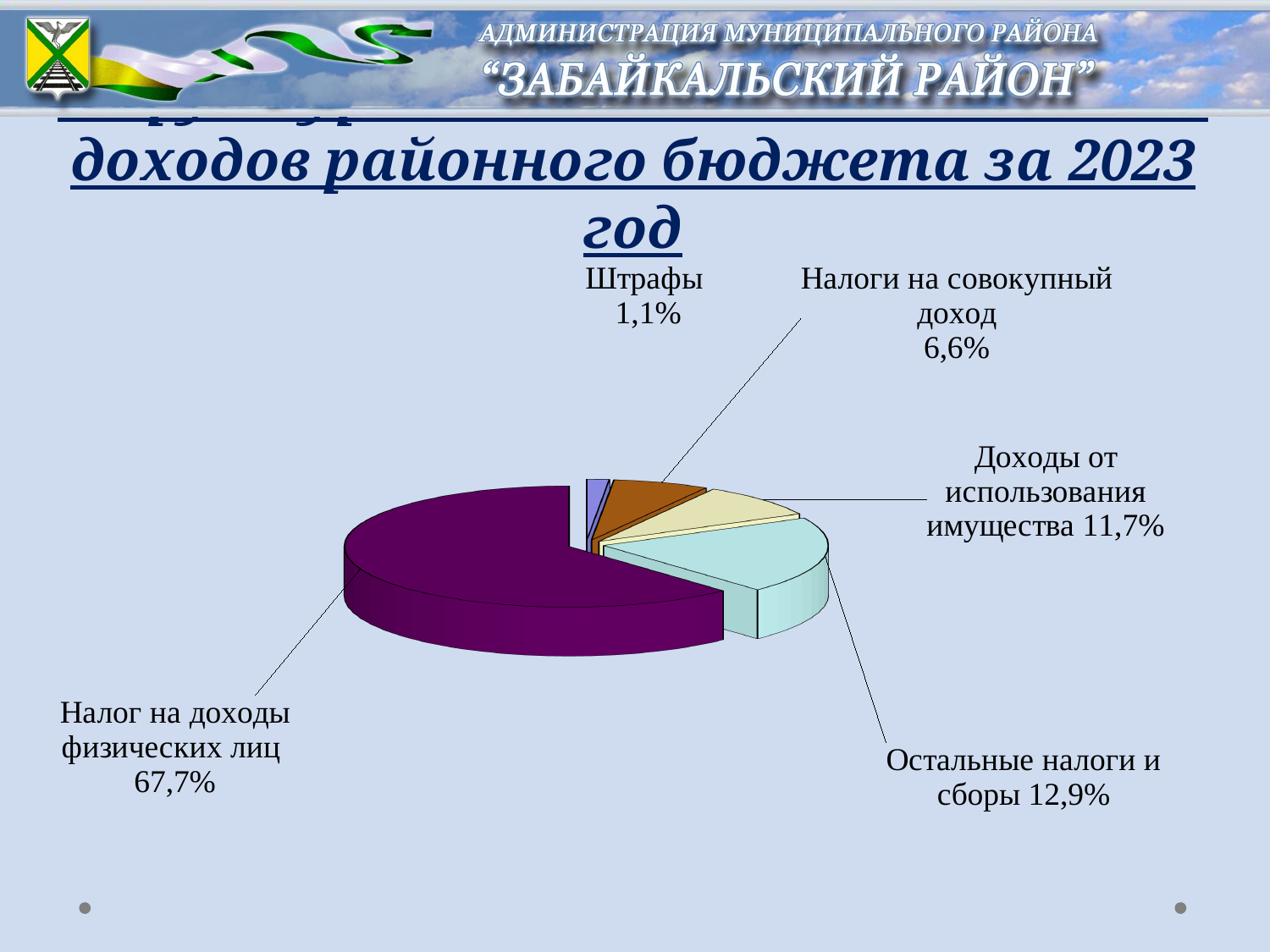
Which category has the largest slice of the pie? Налог на доходы физических лиц What share of the pie does Доходы от использования имущества represent? 11,7% What is the difference in percentage points between Налоги на совокупный доход and Штрафы? 5,5 What share of the pie does Налоги на совокупный доход represent? 6,6% Which category has the smallest slice of the pie? Штрафы What kind of chart is shown on the slide? Pie chart What share of the pie does Остальные налоги и сборы represent? 12,9% What share of the pie does Штрафы represent? 1,1% What is the difference in percentage points between Налог на доходы физических лиц and Остальные налоги и сборы? 54,8 Which is larger, the share for Остальные налоги и сборы or the share for Доходы от использования имущества? Остальные налоги и сборы What share of the pie does Налог на доходы физических лиц represent? 67,7% How many slices does the pie chart have? 5